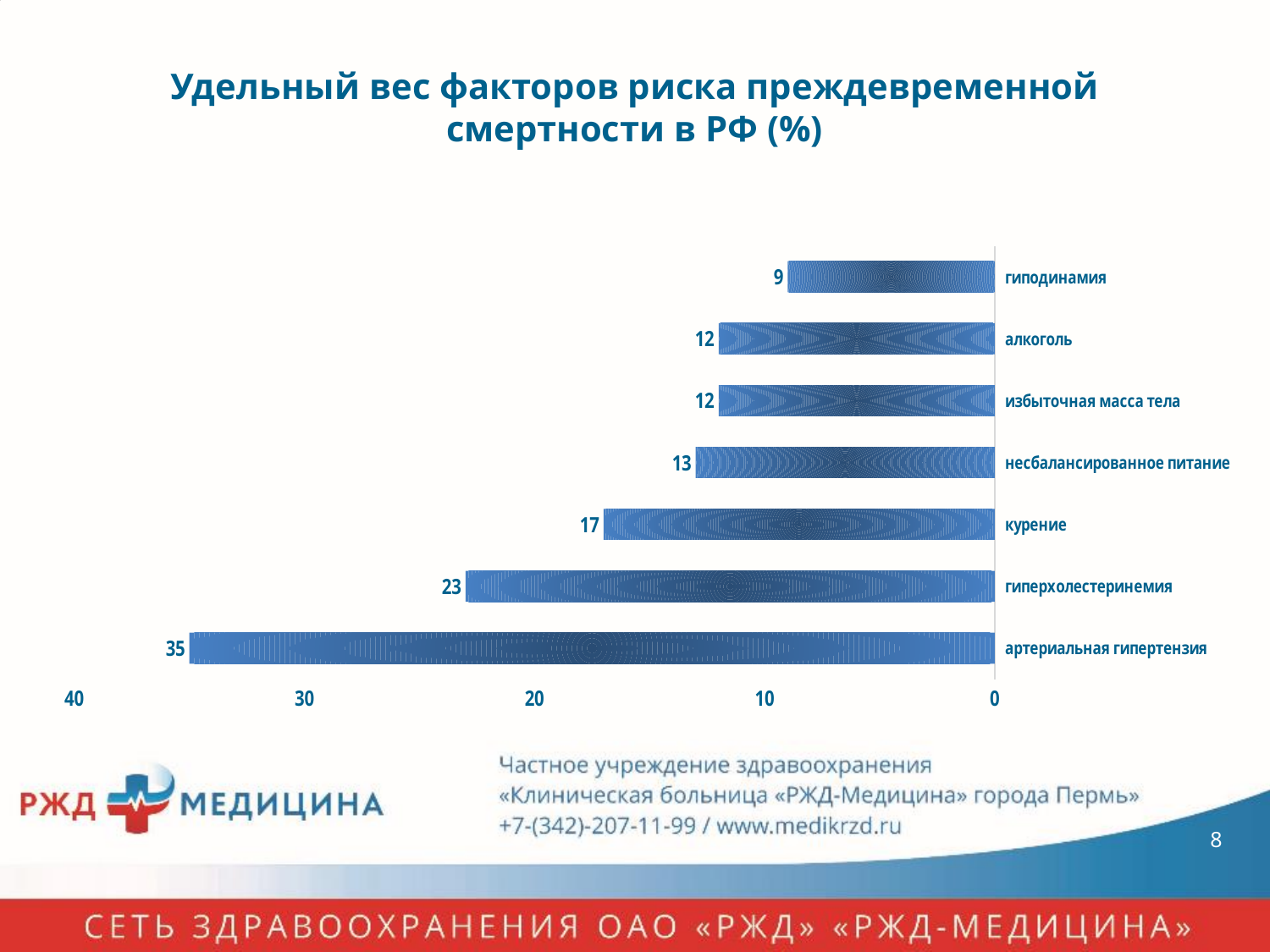
How many risk factors are shown in the chart? 7 Which risk factor has the lowest value? гиподинамия Which is larger, the value for курение or the value for алкоголь? курение What is the value for курение? 17 What is the value for гиподинамия? 9 Is the value for гиперхолестеринемия greater or less than 20? greater What kind of chart is shown on the slide? bar chart What is the title of the chart? Удельный вес факторов риска преждевременной смертности в РФ (%) What is the value for артериальная гипертензия? 35 What is the value for несбалансированное питание? 13 What is the difference between the values for артериальная гипертензия and гиперхолестеринемия? 12 Which risk factor has the highest value? артериальная гипертензия